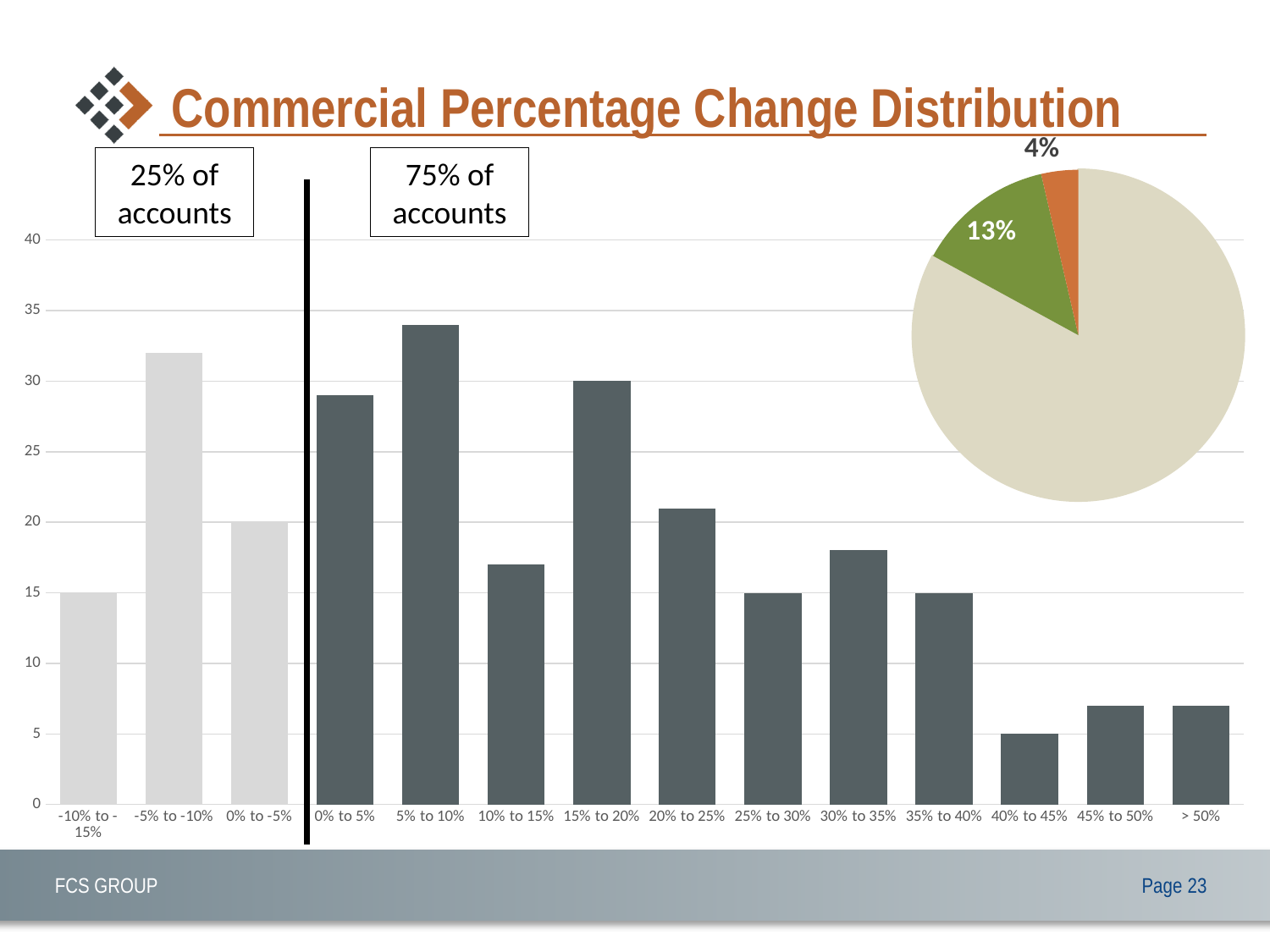
In the bar chart, how many categories are shown on the x axis? 14 In the bar chart, is the value for 5% to 10% greater or less than 30? greater In the bar chart, which category has the highest value? 5% to 10% In the bar chart, what is the value for the 40% to 45% category? 5 According to the text box on the left of the bar chart, what share of accounts falls in the light grey bars? 25% of accounts In the bar chart, which category has the lowest value? 40% to 45% In the bar chart, what is the value for the 0% to -5% category? 20 What kind of chart is the chart on the left of the slide? bar chart In the pie chart, what percentage is shown on the green slice? 13% In the bar chart, what is the difference between the values for 0% to -5% and -10% to -15%? 5